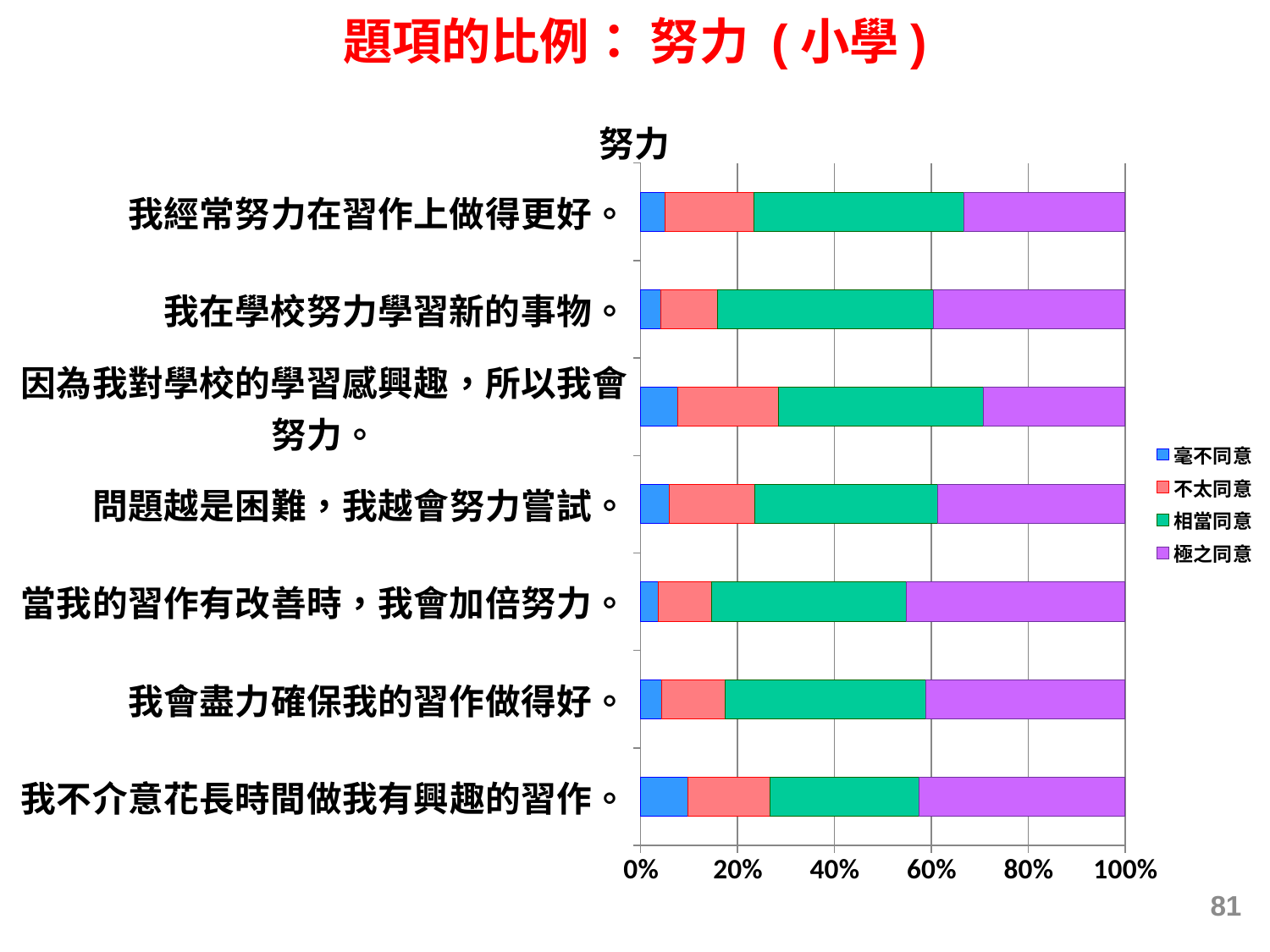
Is the 毫不同意 share for 「我不介意花長時間做我有興趣的習作。」 greater or less than 20%? less What kind of chart is shown on the slide? Stacked bar chart Is the 相當同意 share for 「我不介意花長時間做我有興趣的習作。」 greater or less than 40%? less Which has the larger 極之同意 share: 「當我的習作有改善時，我會加倍努力。」 or 「因為我對學校的學習感興趣，所以我會努力。」? 當我的習作有改善時，我會加倍努力。 Is the 極之同意 share for 「當我的習作有改善時，我會加倍努力。」 greater or less than 40%? greater What is the title of the chart? 努力 How many series does the legend list? 4 Which has the larger 毫不同意 share: 「我不介意花長時間做我有興趣的習作。」 or 「當我的習作有改善時，我會加倍努力。」? 我不介意花長時間做我有興趣的習作。 Which legend entry is shown in purple? 極之同意 Which statement has the largest 毫不同意 share? 我不介意花長時間做我有興趣的習作。 How many categories (statements) are plotted in the chart? 7